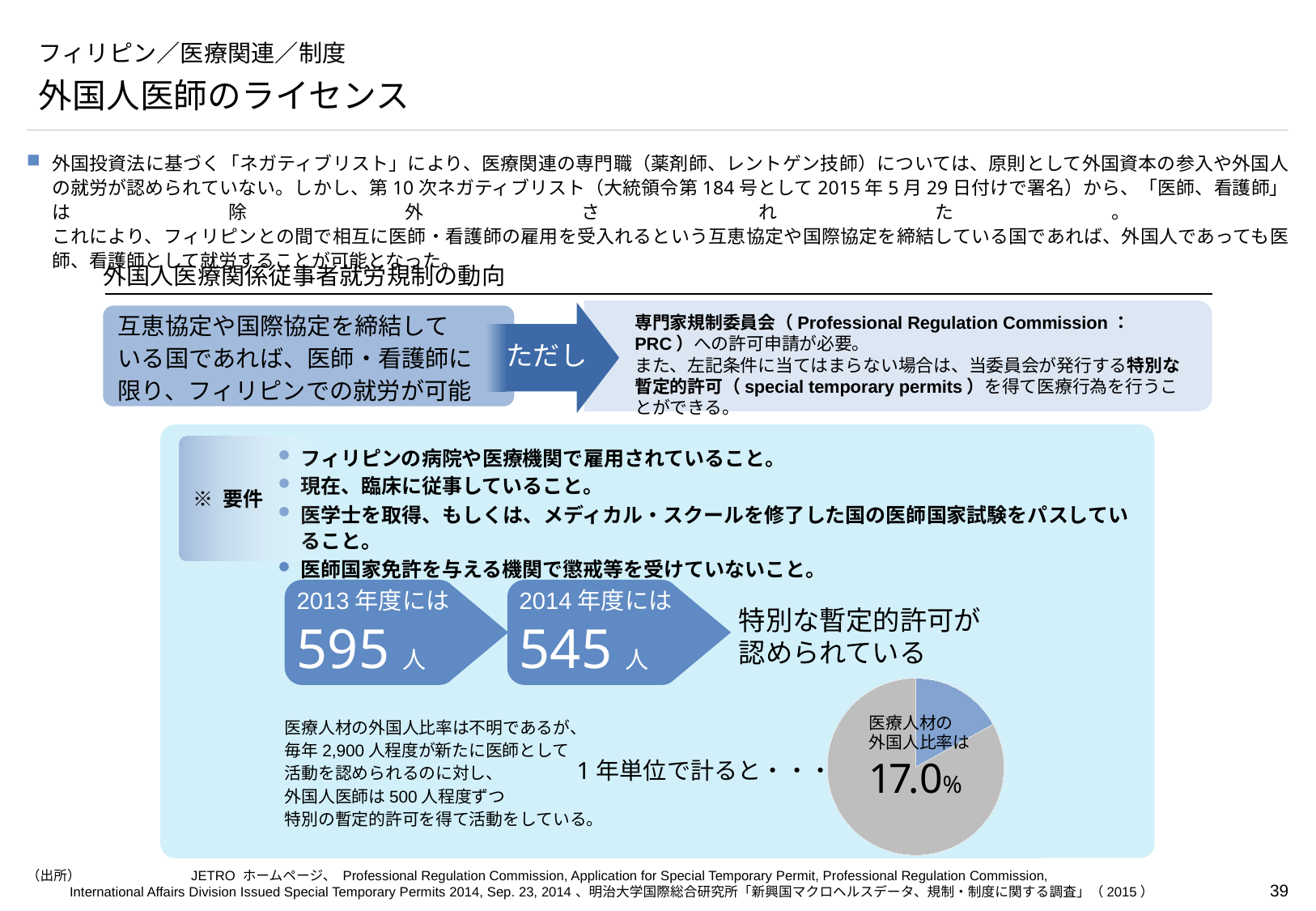
How many slices does the pie chart have? 2 What percentage is printed on the pie chart? 17.0% Which slice of the pie chart is larger, the blue slice or the gray slice? the gray slice What colour is the slice of the pie chart that represents 17.0%? blue What kind of chart is shown at the bottom right of the slide? pie chart What share of the pie does the blue slice represent? 17.0% What does the pie chart represent, according to the label inside it? 医療人材の外国人比率 Which slice of the pie chart is the smallest? the blue slice